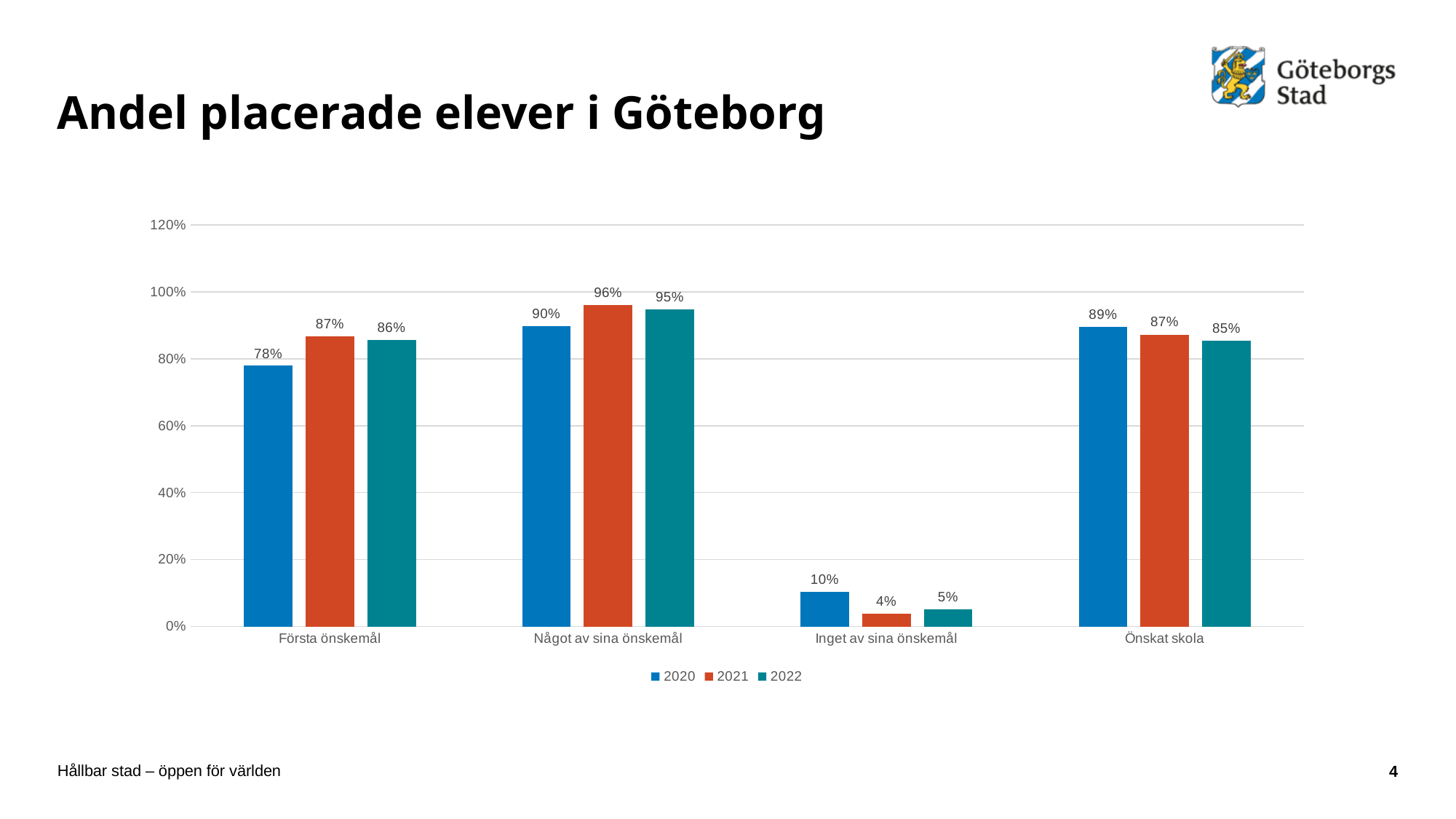
What is the value for 2022 in the Inget av sina önskemål category? 5% What is the value for 2020 in the Första önskemål category? 78% Which category has the highest value for the 2022 series? Något av sina önskemål Which is larger in the Inget av sina önskemål category: the 2020 value or the 2021 value? 2020 What is the value for 2020 in the Önskat skola category? 89% What is the title of the slide containing the chart? Andel placerade elever i Göteborg What is the difference between the 2021 and 2020 values in the Första önskemål category? 9 percentage points How many categories are shown on the x axis? 4 What kind of chart is shown on the slide? Bar chart How many series does the legend list? 3 Which category has the lowest value for the 2021 series? Inget av sina önskemål What is the value for 2021 in the Något av sina önskemål category? 96%